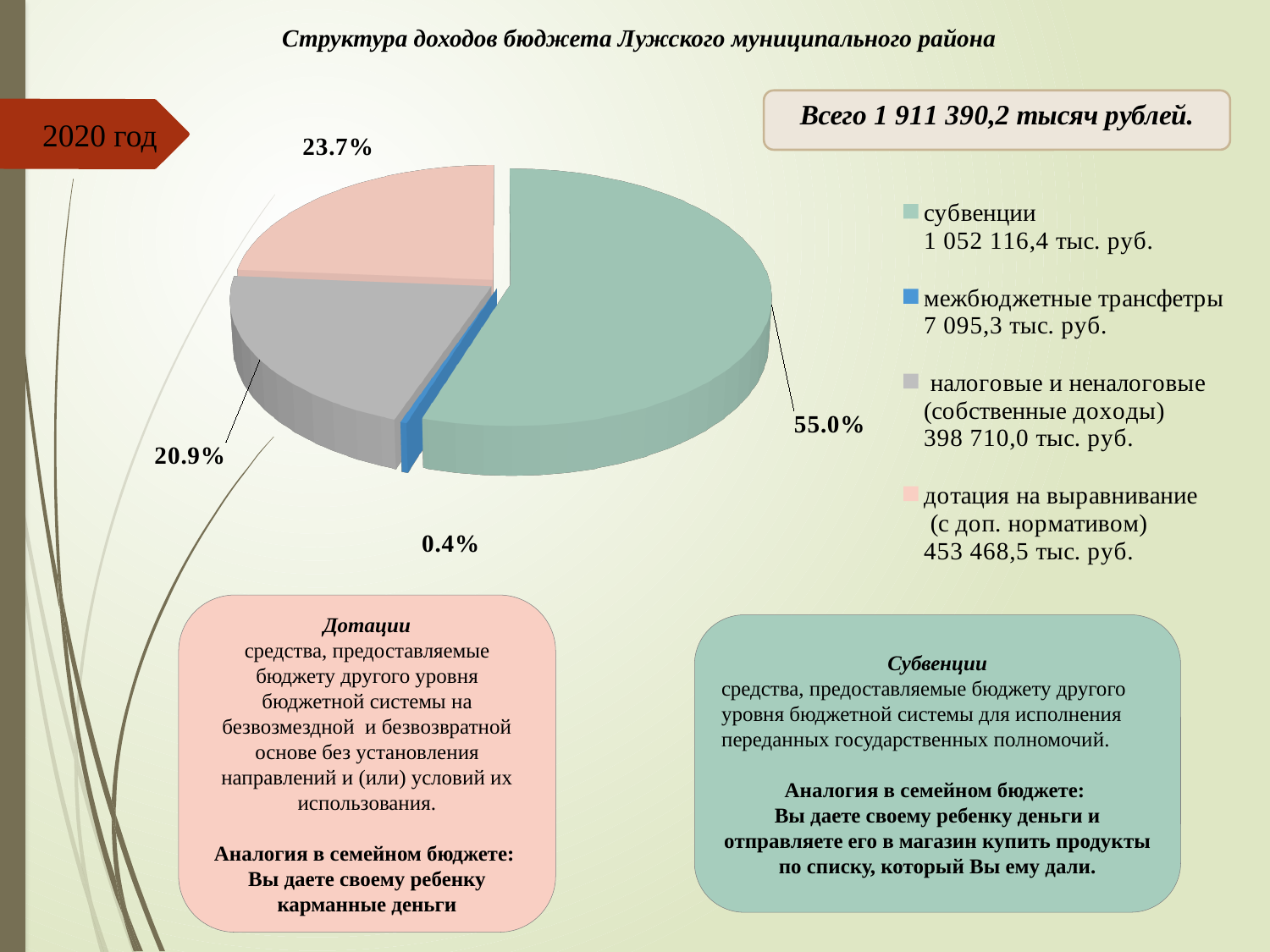
What share of the pie is labelled for дотация на выравнивание (с доп. нормативом)? 23.7% Which slice is larger: дотация на выравнивание or налоговые и неналоговые (собственные доходы)? дотация на выравнивание Which category has the largest slice of the pie? субвенции What is the difference in percentage points between the субвенции slice and the дотация на выравнивание slice? 31.3 What share of the pie is labelled for субвенции? 55.0% Which category has the smallest slice of the pie? межбюджетные трансферты What share of the pie is labelled for налоговые и неналоговые (собственные доходы)? 20.9% What kind of chart is shown on the slide? pie chart How many entries does the legend list? 4 What total amount is stated in the box above the legend? 1 911 390,2 тысяч рублей How many slices does the pie chart have? 4